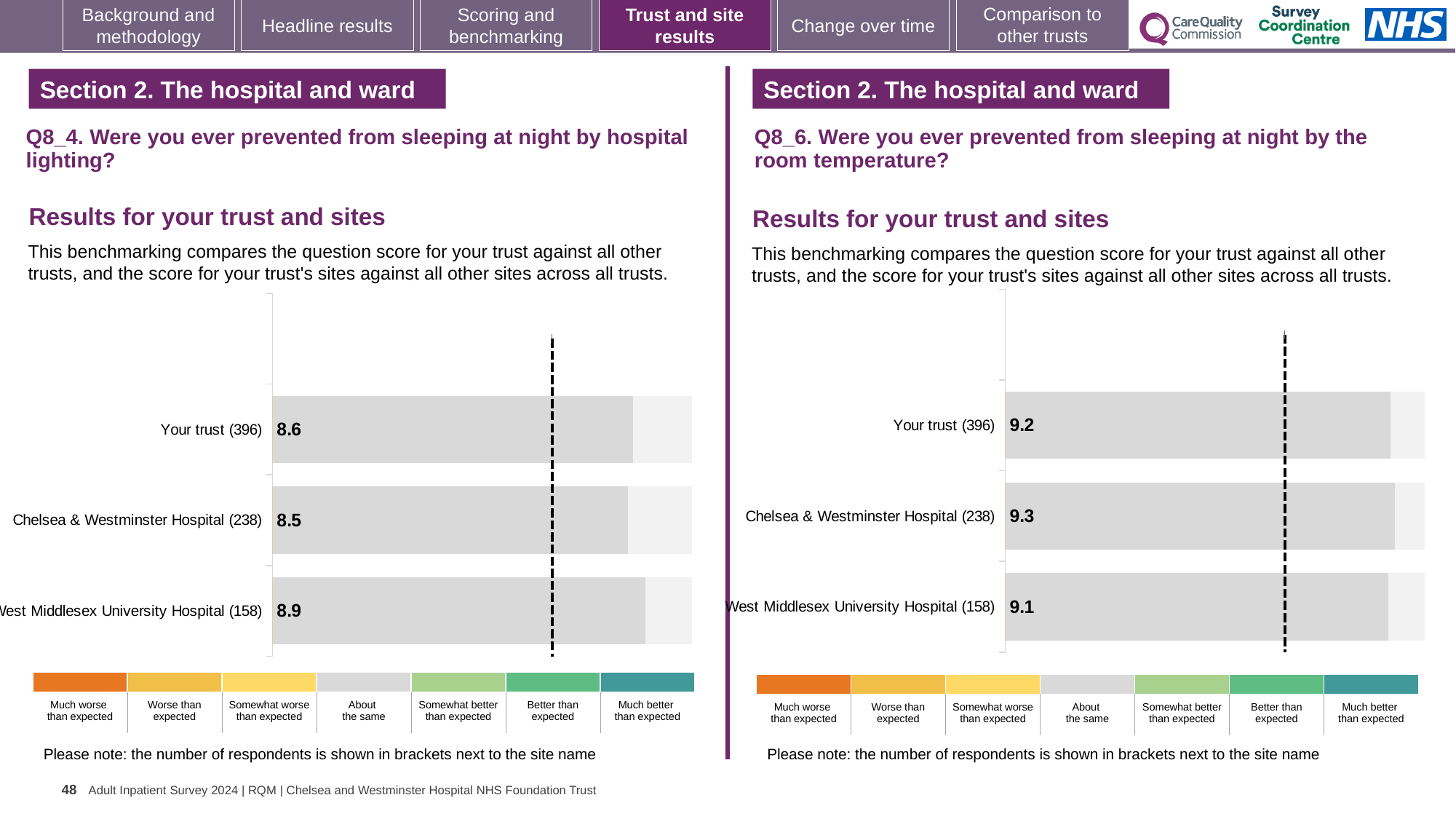
On the Q8_6 chart (room temperature), what is the difference between the scores for Chelsea & Westminster Hospital (238) and Your trust (396)? 0.1 What type of chart is used on the Q8_6 chart (room temperature)? Bar chart On the Q8_4 chart (hospital lighting), what is the score for Your trust (396)? 8.6 On the Q8_4 chart (hospital lighting), what is the difference between the scores for West Middlesex University Hospital (158) and Chelsea & Westminster Hospital (238)? 0.4 On the Q8_6 chart (room temperature), what is the score for West Middlesex University Hospital (158)? 9.1 On the Q8_4 chart (hospital lighting), which site or trust has the lowest score? Chelsea & Westminster Hospital (238) On the Q8_6 chart (room temperature), which has the larger score: Your trust (396) or West Middlesex University Hospital (158)? Your trust (396) On the Q8_4 chart (hospital lighting), which site or trust has the highest score? West Middlesex University Hospital (158) On the Q8_4 chart (hospital lighting), what is the score for West Middlesex University Hospital (158)? 8.9 On the Q8_6 chart (room temperature), which site or trust has the lowest score? West Middlesex University Hospital (158) On the Q8_6 chart (room temperature), what is the score for Chelsea & Westminster Hospital (238)? 9.3 How many bars are plotted on the Q8_4 chart (hospital lighting)? 3